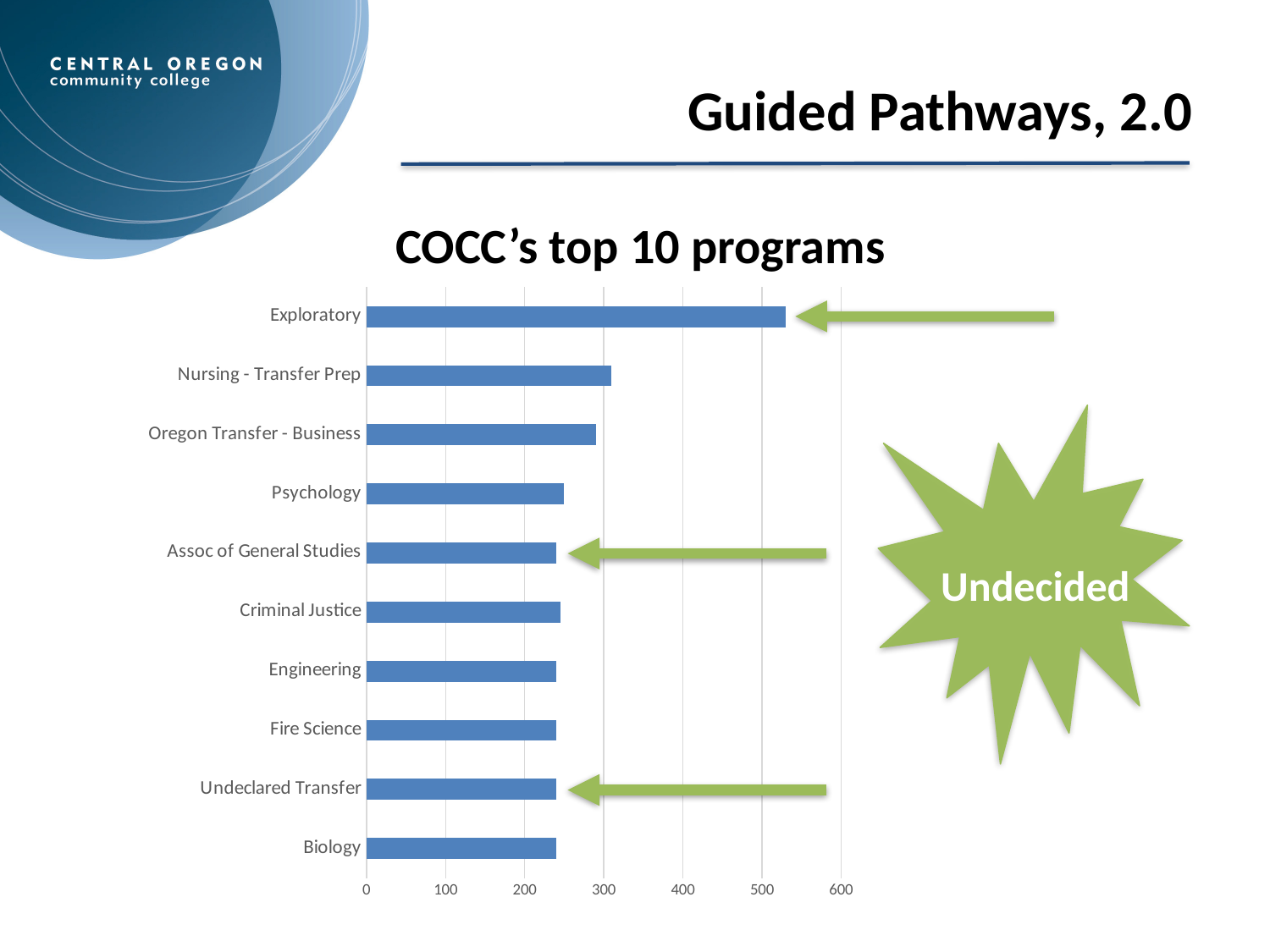
Which has a larger value, Exploratory or Nursing - Transfer Prep? Exploratory How many programs (categories) are plotted in the chart? 10 Is the value for Biology greater or less than 300? less Which has a larger value, Nursing - Transfer Prep or Psychology? Nursing - Transfer Prep Which program has the highest value in the chart? Exploratory Is the value for Exploratory greater or less than 500? greater What is the title of the chart? COCC's top 10 programs Is the value for Psychology greater or less than 200? greater What kind of chart is shown on the slide? Bar chart Which program is listed at the top of the chart? Exploratory